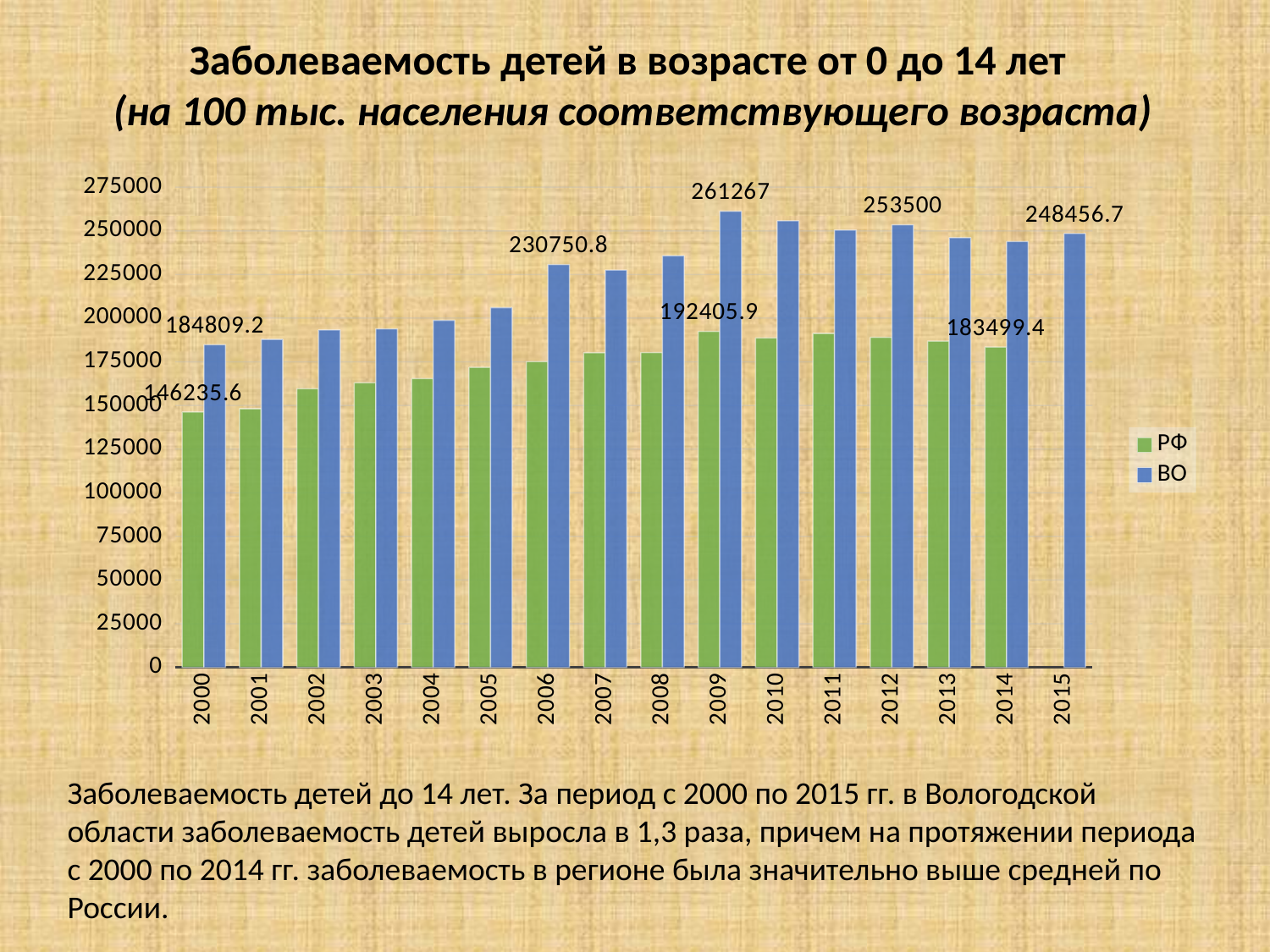
What is the difference between the ВО and РФ values in 2000? 38573.6 What is the value for РФ in 2000? 146235.6 In which year is the ВО value highest? 2009 What is the value for ВО in 2009? 261267 How many years are shown on the x axis? 16 Do the ВО values rise or fall from 2000 to 2009? rise How many series does the legend list? 2 In which year is the ВО value lowest? 2000 What is the value for ВО in 2015? 248456.7 What kind of chart is shown on the slide? bar chart Is the value for РФ in 2005 greater or less than 175000? less Which is larger in 2009, the ВО value or the РФ value? ВО